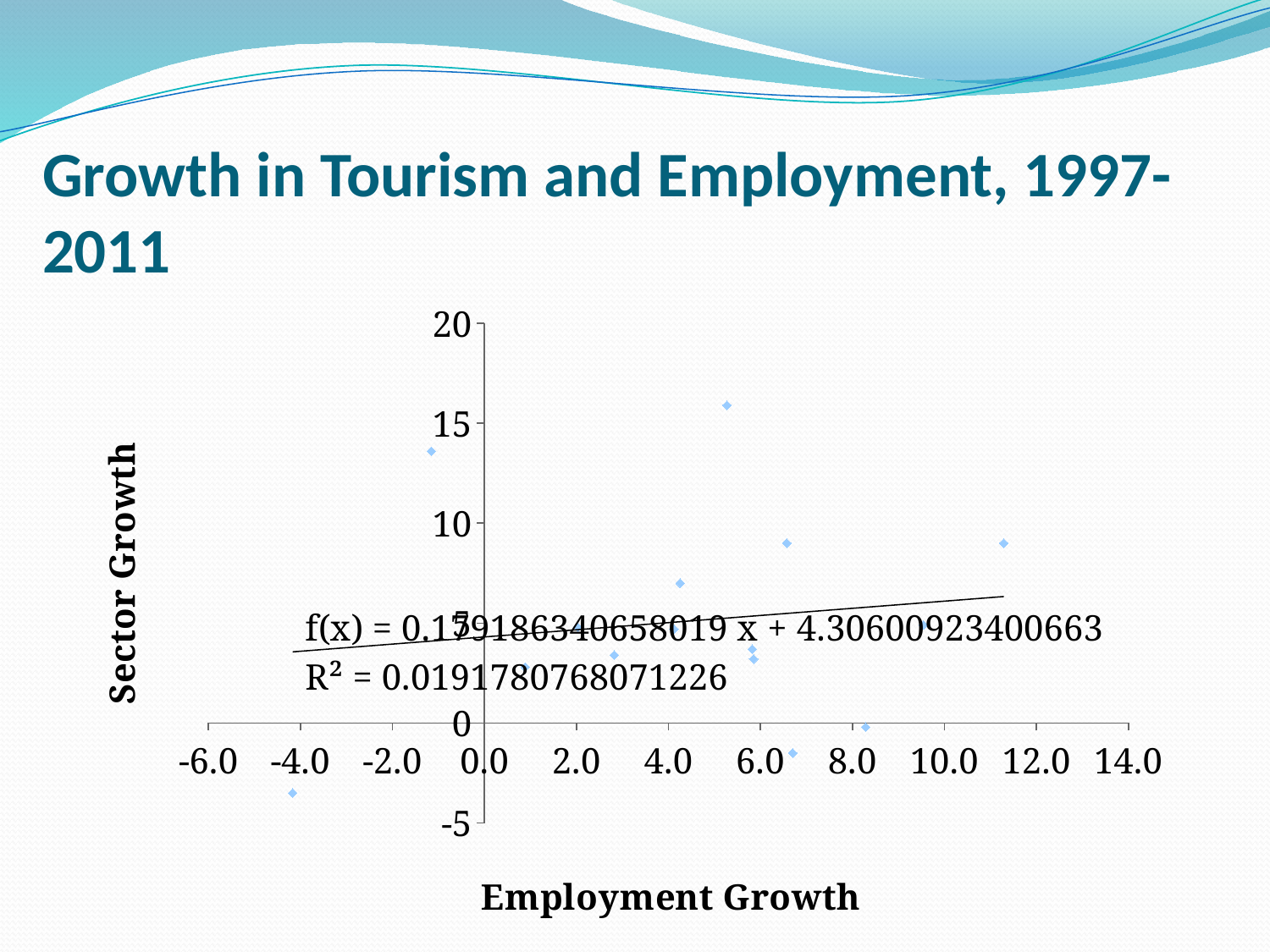
Is the lowest Sector Growth value plotted greater or less than 0? less What is the title of the chart? Growth in Tourism and Employment, 1997-2011 What is the highest value shown on the vertical axis? 20 Is the Sector Growth value of the point with the lowest Employment Growth (around -4.0) greater or less than 5? less What is the trendline equation printed on the chart? f(x) = 0.179186340658019 x + 4.30600923400663 What is the lowest value shown on the horizontal axis? -6.0 What kind of chart is shown on the slide? scatter plot What is the R² value printed on the chart? R² = 0.0191780768071226 Is the highest Sector Growth value plotted greater or less than 15? greater What is the label of the horizontal axis? Employment Growth Does the fitted trendline rise or fall as Employment Growth increases? rises